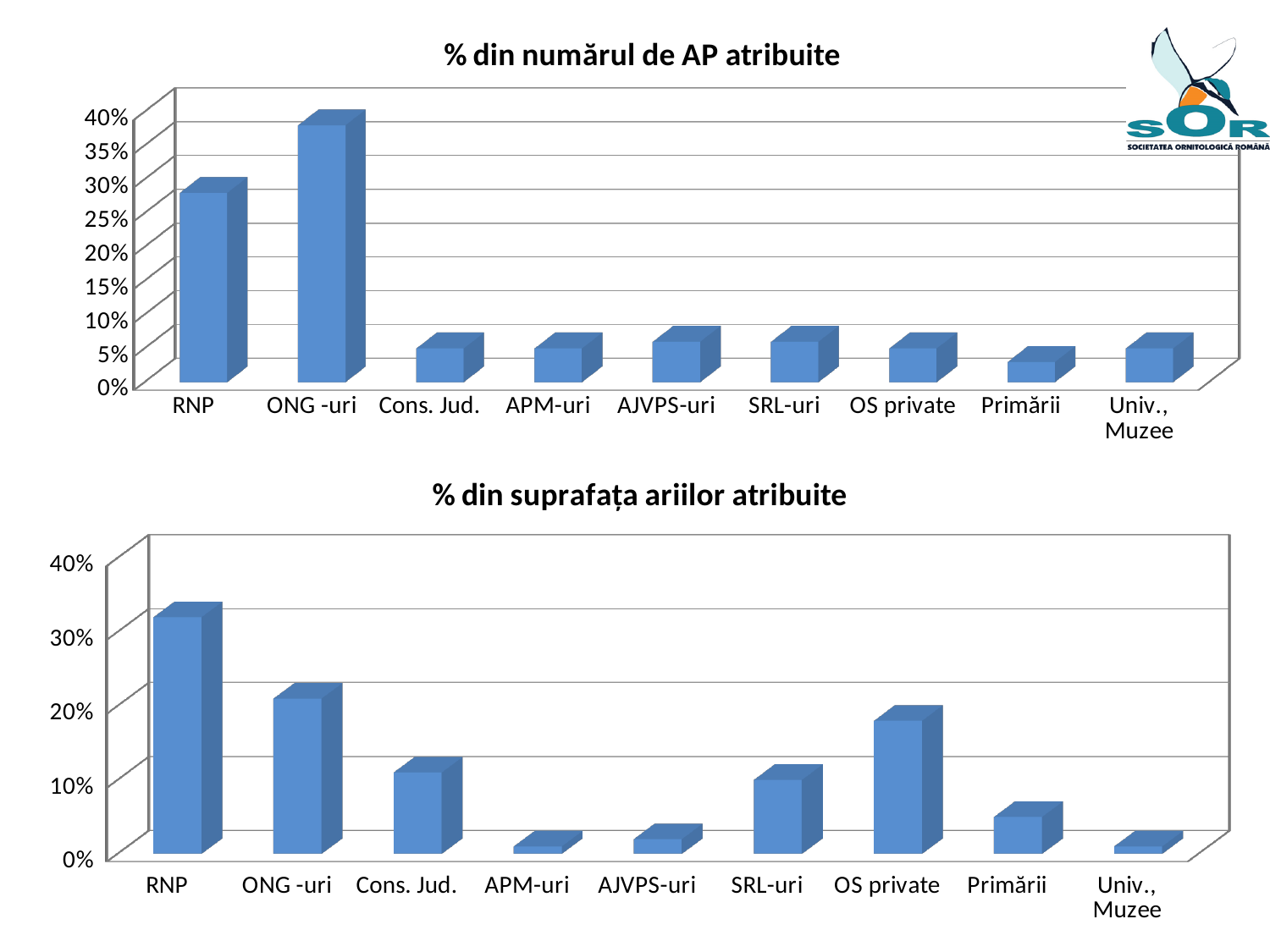
In the bottom chart '% din suprafața ariilor atribuite', is the value for OS private greater or less than 20%? less What is the title of the bottom chart on the slide? % din suprafața ariilor atribuite In the top chart '% din numărul de AP atribuite', is the value for RNP greater or less than 30%? less How many categories are shown on the x axis of the top chart '% din numărul de AP atribuite'? 9 In the top chart '% din numărul de AP atribuite', which category has the lowest value? Primării In the top chart '% din numărul de AP atribuite', which category has the highest value? ONG -uri In the bottom chart '% din suprafața ariilor atribuite', is the value for RNP greater or less than 30%? greater In the bottom chart '% din suprafața ariilor atribuite', which category has the highest value? RNP In the bottom chart '% din suprafața ariilor atribuite', which is larger, the value for OS private or the value for SRL-uri? OS private In the bottom chart '% din suprafața ariilor atribuite', which is larger, the value for ONG -uri or the value for Cons. Jud.? ONG -uri What kind of chart is the top chart titled '% din numărul de AP atribuite'? bar chart